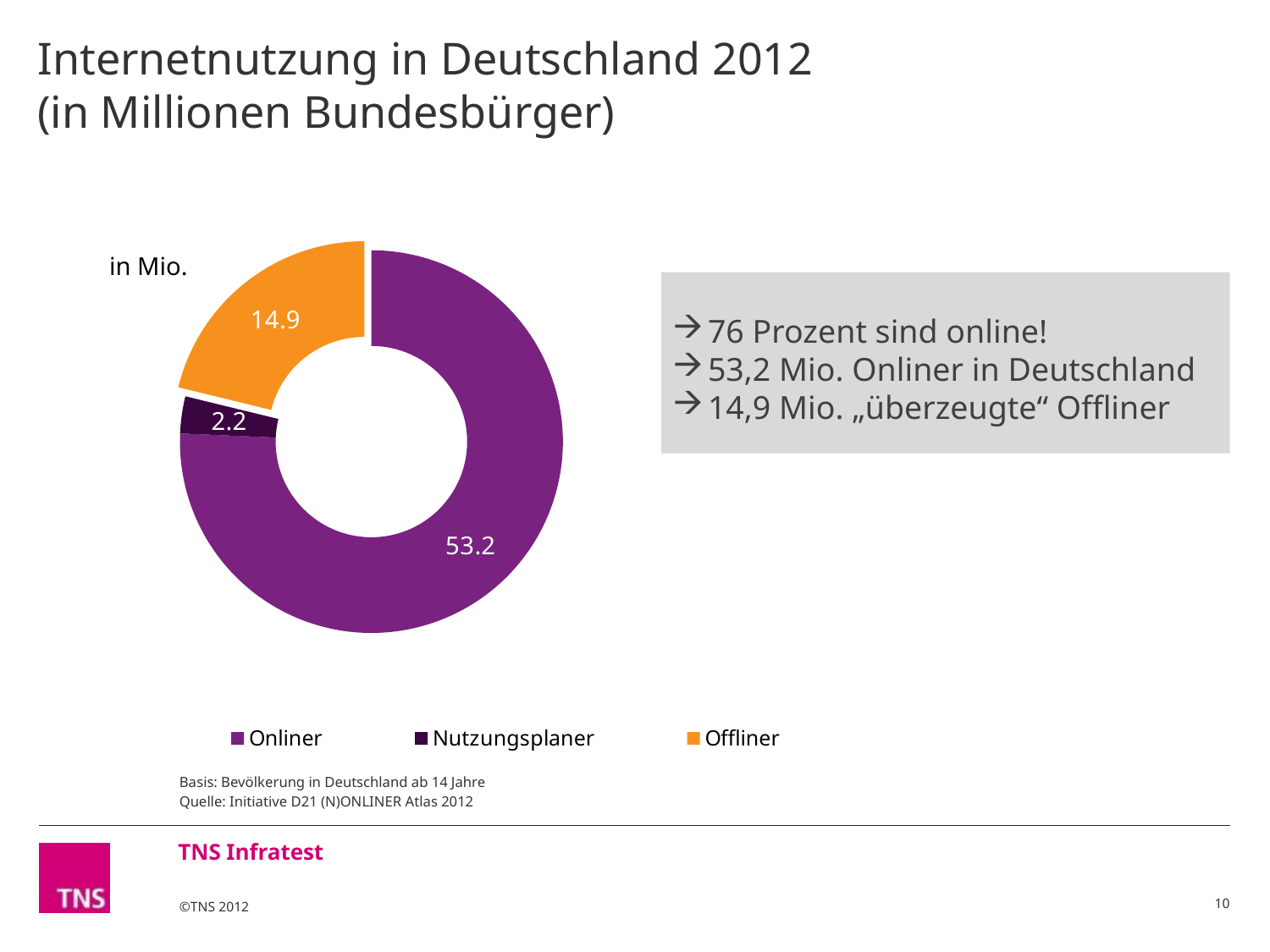
Which category has the largest slice in the chart? Onliner What is the difference between the Offliner value and the Nutzungsplaner value? 12.7 What is the value for Onliner in the chart? 53.2 What colour is the Offliner slice in the chart? Orange Which category has the smallest slice in the chart? Nutzungsplaner What is the difference between the Onliner value and the Offliner value? 38.3 Which is larger, the value for Offliner or the value for Nutzungsplaner? Offliner What is the value for Offliner in the chart? 14.9 What type of chart is shown on the slide? Pie chart (donut) How many categories does the chart show? 3 What is the total of all three slices in the chart? 70.3 What is the value for Nutzungsplaner in the chart? 2.2